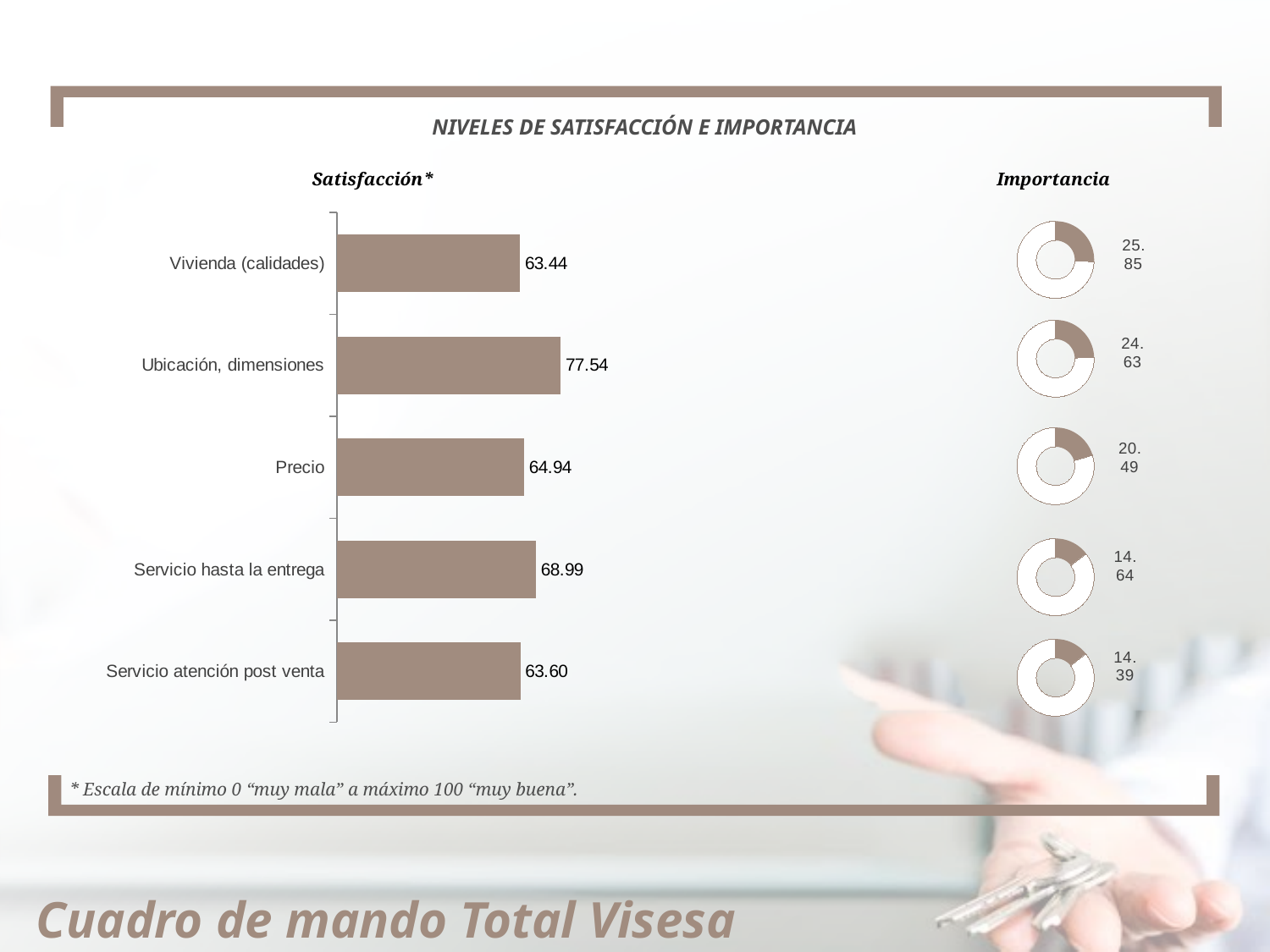
What is the title of the chart section on the slide? NIVELES DE SATISFACCIÓN E IMPORTANCIA In the Satisfacción bar chart, which category has the highest value? Ubicación, dimensiones In the Importancia donut charts, what is the value for Servicio hasta la entrega? 14.64 What kind of chart is used for Satisfacción? Bar chart In the Satisfacción bar chart, which category has the lowest value? Vivienda (calidades) In the Satisfacción bar chart, which is larger: Precio or Servicio hasta la entrega? Servicio hasta la entrega In the Satisfacción bar chart, what is the value for Servicio atención post venta? 63.60 In the Satisfacción bar chart, what is the value for Ubicación, dimensiones? 77.54 In the Importancia donut charts, what is the value for Vivienda (calidades)? 25.85 How many categories are shown in the Satisfacción bar chart? 5 In the Satisfacción bar chart, what is the difference between Ubicación, dimensiones and Servicio hasta la entrega? 8.55 In the Satisfacción bar chart, what is the value for Precio? 64.94